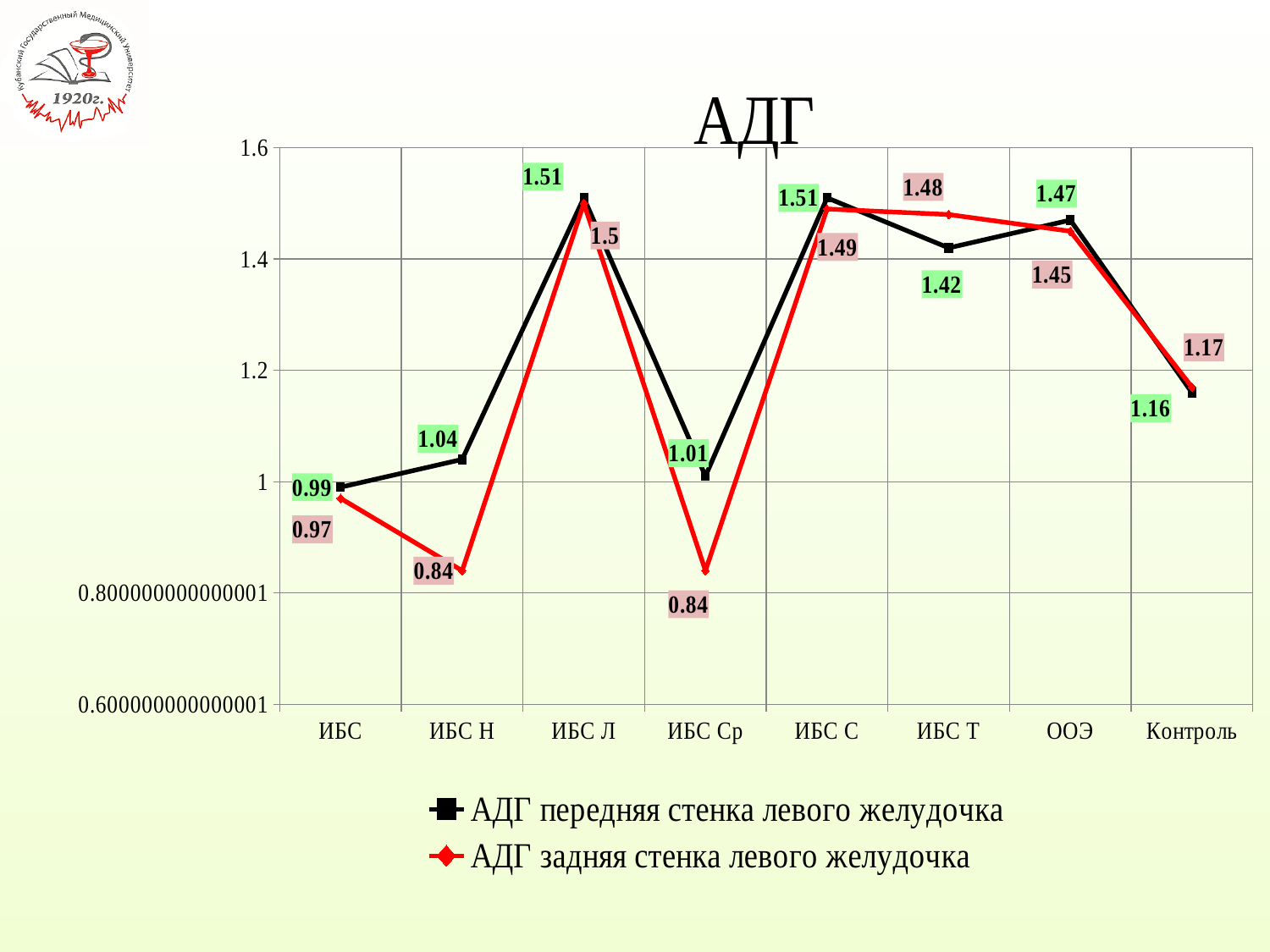
For ИБС Т, which series has the larger value: АДГ передняя стенка левого желудочка or АДГ задняя стенка левого желудочка? АДГ задняя стенка левого желудочка Which category has the highest value for АДГ задняя стенка левого желудочка? ИБС Л What is the value of АДГ передняя стенка левого желудочка for ИБС Н? 1.04 How many series does the legend list? 2 What is the value of АДГ задняя стенка левого желудочка for ИБС Ср? 0.84 What kind of chart is shown on the slide? Line chart What is the value of АДГ передняя стенка левого желудочка for ИБС Т? 1.42 What is the value of АДГ задняя стенка левого желудочка for Контроль? 1.17 How many categories are shown on the x axis? 8 Which category has the lowest value for АДГ передняя стенка левого желудочка? ИБС What is the title of the chart? АДГ What is the difference between the АДГ передняя стенка левого желудочка and АДГ задняя стенка левого желудочка values for ИБС Н? 0.2